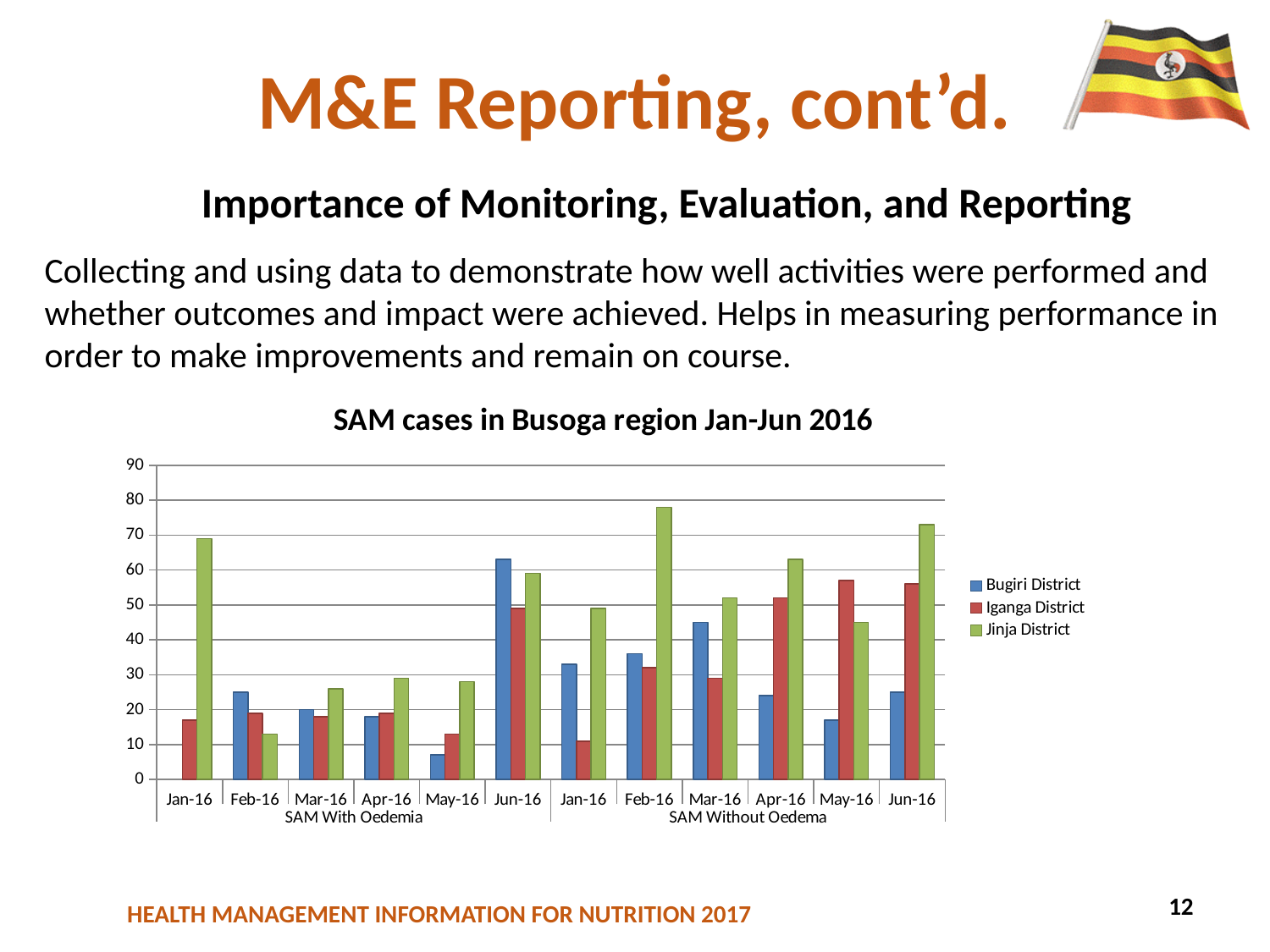
In Jun-16 under SAM With Oedemia, which is larger: Bugiri District or Iganga District? Bugiri District How many month categories are shown under the SAM With Oedemia group? 6 Is the value for Jinja District in Feb-16 under SAM Without Oedema greater or less than 70? greater Which districts are listed in the chart legend? Bugiri District, Iganga District, Jinja District What kind of chart is shown on the slide? bar chart Which district has the lowest value in May-16 under SAM With Oedemia? Bugiri District How many series does the legend of the chart list? 3 Which district has the highest value in Feb-16 under SAM Without Oedema? Jinja District Is the value for Jinja District in Jan-16 under SAM With Oedemia greater or less than 60? greater In May-16 under SAM Without Oedema, which is larger: Iganga District or Jinja District? Iganga District What is the title of the chart? SAM cases in Busoga region Jan-Jun 2016 Is the value for Bugiri District in May-16 under SAM With Oedemia greater or less than 10? less